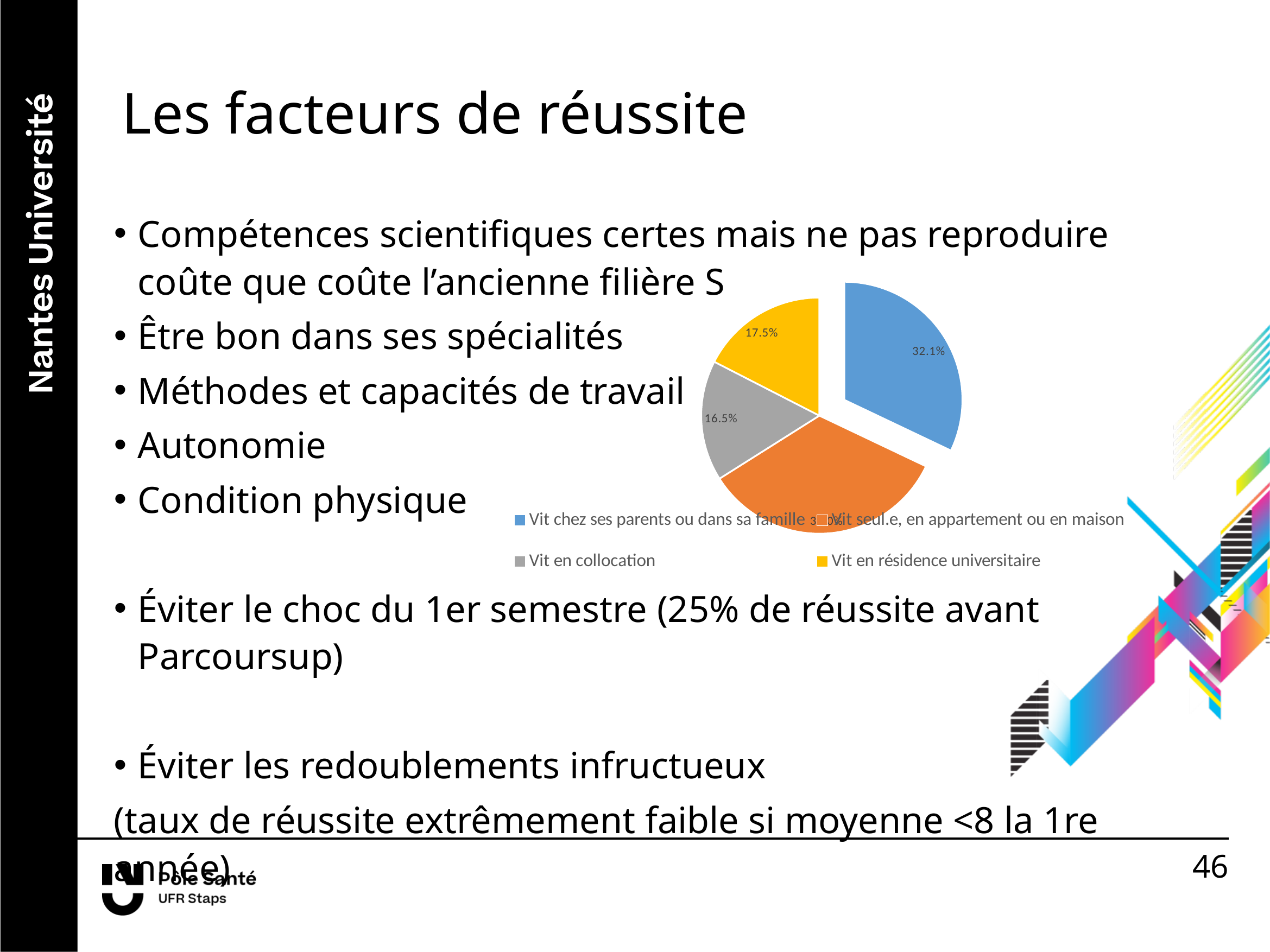
Which is larger: the slice for 'Vit chez ses parents ou dans sa famille' or the slice for 'Vit en collocation'? Vit chez ses parents ou dans sa famille What is the difference in percentage points between 'Vit chez ses parents ou dans sa famille' (32.1%) and 'Vit en collocation' (16.5%)? 15.6 What percentage is shown for the slice 'Vit en résidence universitaire'? 17.5% Which category has the smallest slice in the pie chart? Vit en collocation Which is larger: the slice for 'Vit en résidence universitaire' or the slice for 'Vit en collocation'? Vit en résidence universitaire What kind of chart is shown on the slide? pie chart How many slices does the pie chart have? 4 Which legend entry is shown in blue? Vit chez ses parents ou dans sa famille What percentage is shown for the slice 'Vit chez ses parents ou dans sa famille'? 32.1% What percentage is shown for the slice 'Vit en collocation'? 16.5% What colour is the slice for 'Vit en résidence universitaire'? yellow What is the difference in percentage points between 'Vit en résidence universitaire' (17.5%) and 'Vit en collocation' (16.5%)? 1.0